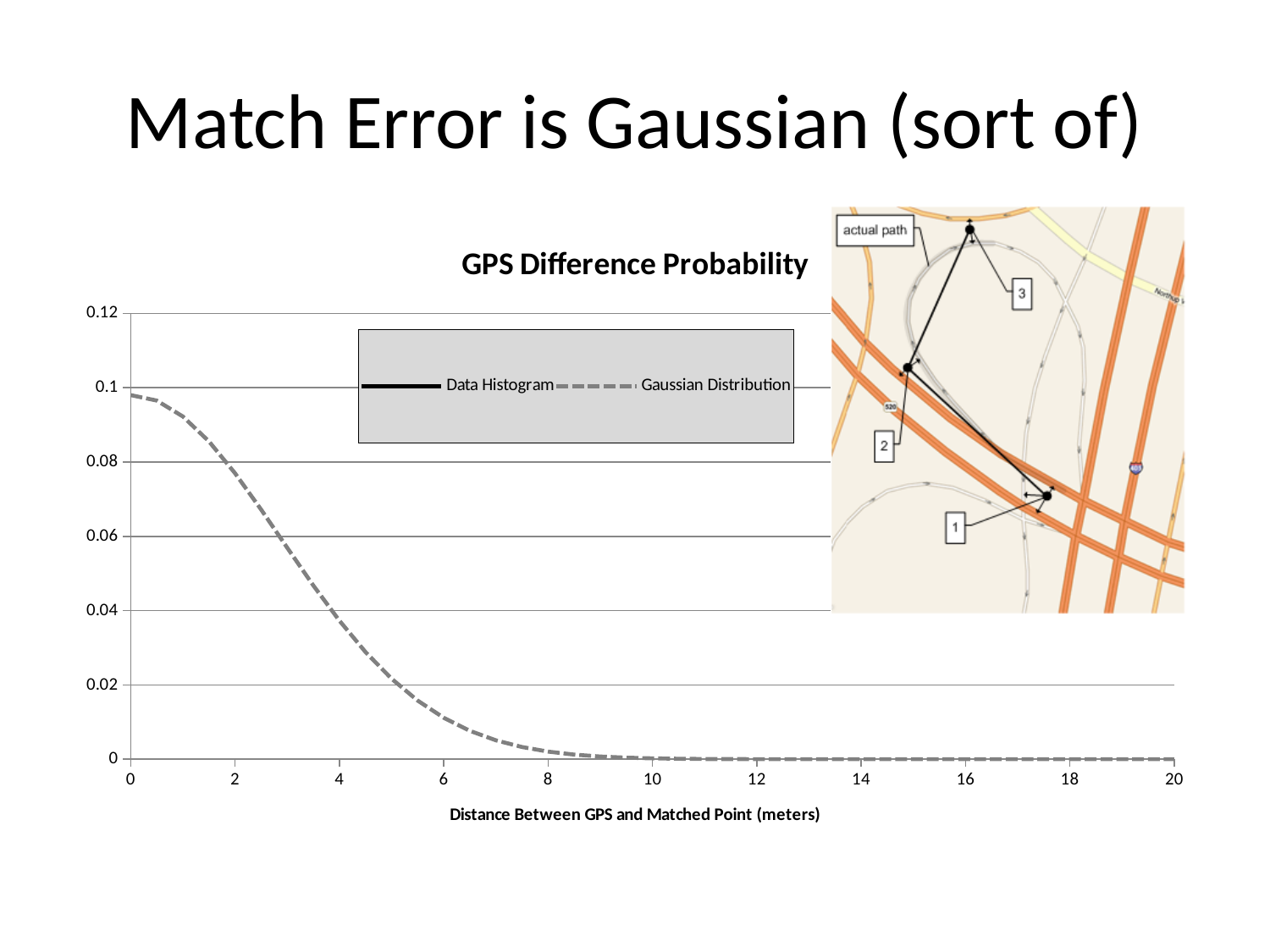
What is the title of the chart on the slide? GPS Difference Probability Is the value of the Gaussian Distribution curve at a distance of 0 meters greater or less than 0.08? greater What is the largest distance shown on the x axis of the chart? 20 How many series does the legend of the GPS Difference Probability chart list? 2 Which is larger on the Gaussian Distribution curve: the value at 2 meters or the value at 6 meters? 2 meters Is the value of the Gaussian Distribution curve at a distance of 6 meters greater or less than 0.02? less Is the value of the Gaussian Distribution curve at a distance of 1 meter greater or less than 0.06? greater What kind of chart is shown on the slide? line chart Does the Gaussian Distribution curve rise or fall as the distance increases along the x axis? fall What is the x-axis label of the chart? Distance Between GPS and Matched Point (meters) What is the highest value shown on the y axis of the chart? 0.12